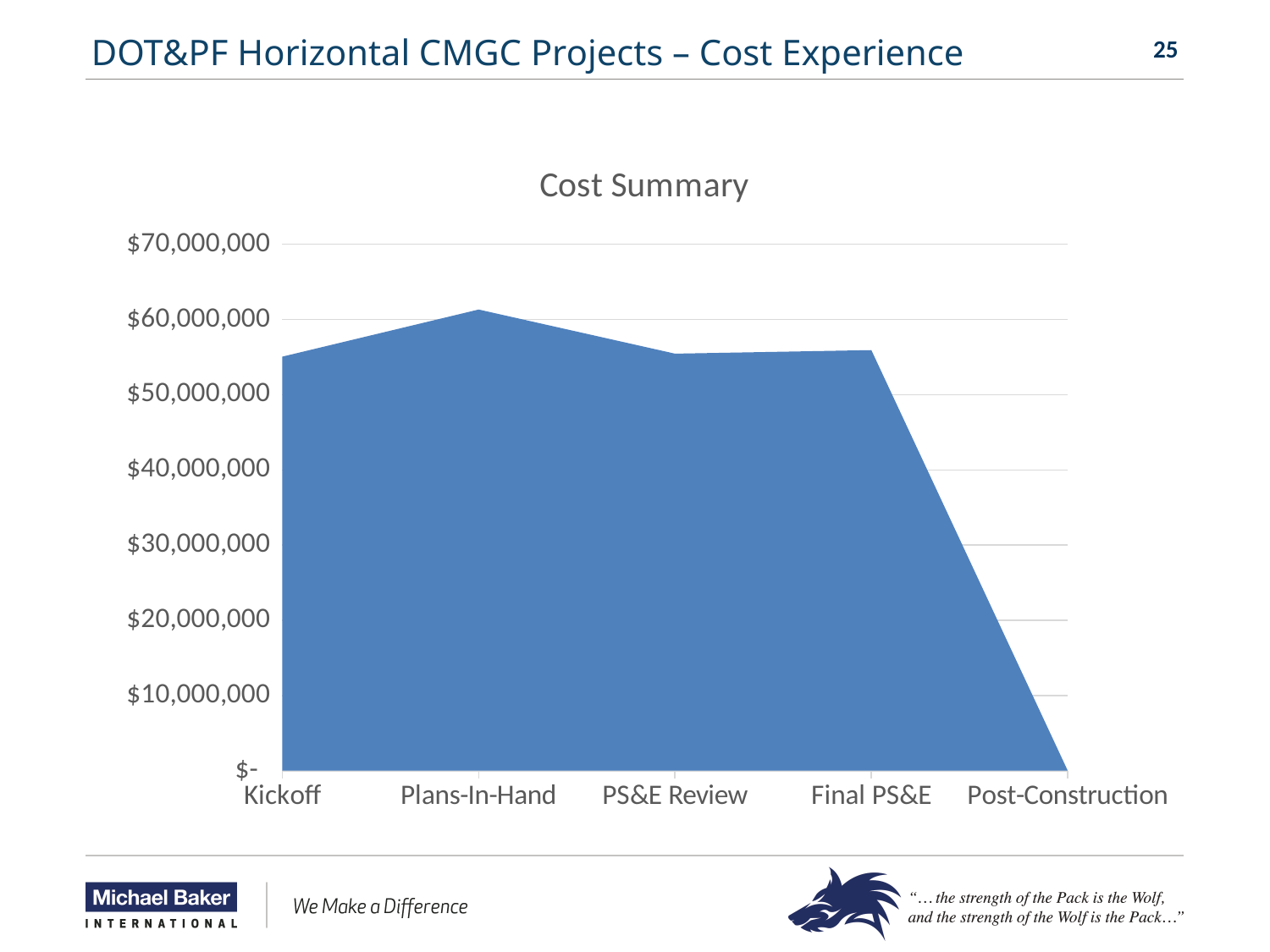
What kind of chart is shown on the slide? Area chart Is the value for Plans-In-Hand greater or less than $60,000,000? greater Which is larger, the cost at Kickoff or the cost at Plans-In-Hand? Plans-In-Hand Does the cost rise or fall from Final PS&E to Post-Construction? fall Is the value for Final PS&E greater or less than $60,000,000? less What is the highest value labelled on the y axis of the Cost Summary chart? $70,000,000 Is the value for Kickoff greater or less than $60,000,000? less How many project stages are shown along the x axis of the Cost Summary chart? 5 Which stage has the lowest cost in the Cost Summary chart? Post-Construction What is the title of the chart? Cost Summary Which stage has the highest cost in the Cost Summary chart? Plans-In-Hand